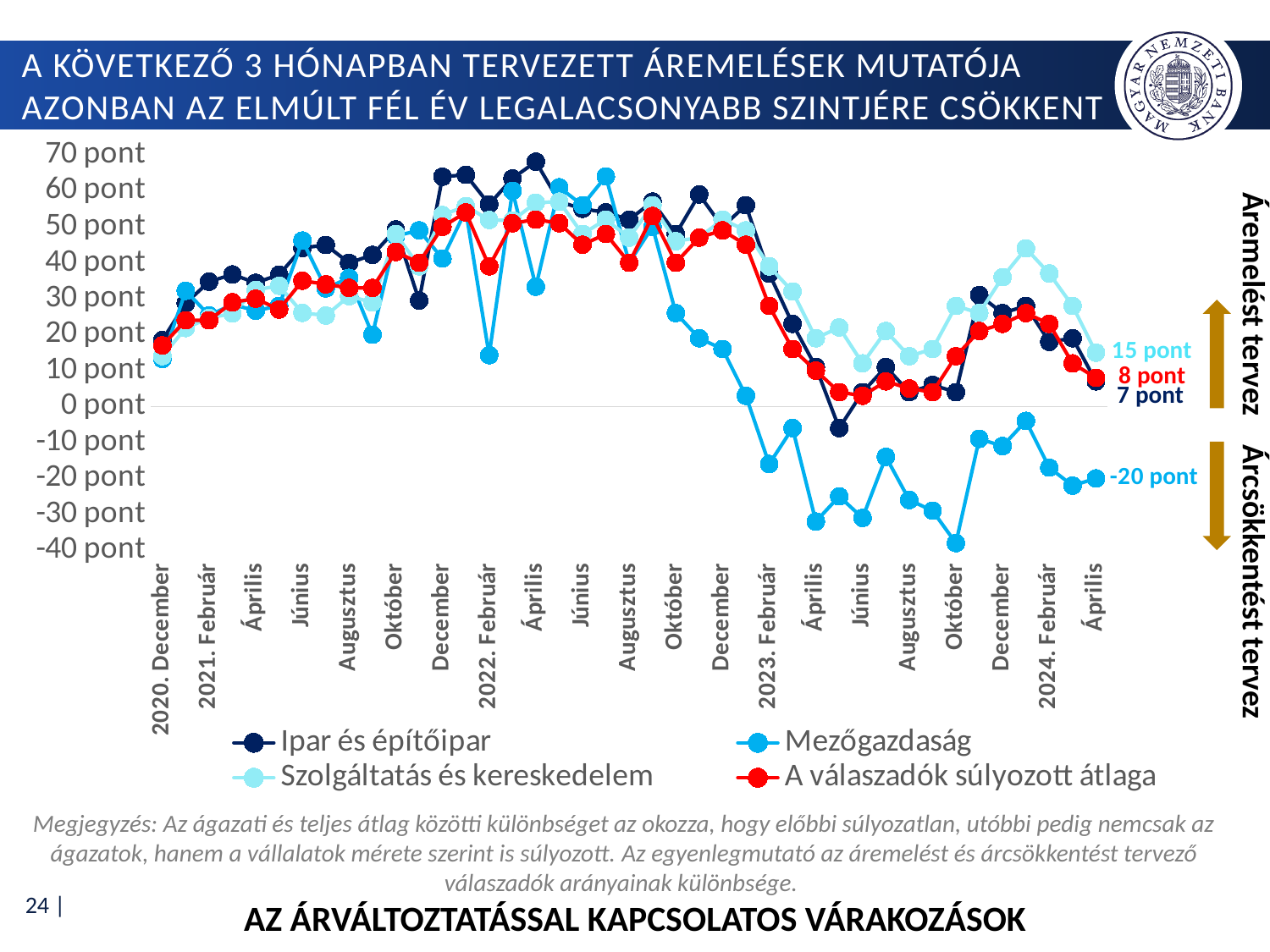
Which series has the lowest value at the last point (2024 Április)? Mezőgazdaság What is the value for Szolgáltatás és kereskedelem at the last point (2024 Április)? 15 pont Is the value for Ipar és építőipar in 2022 Április greater or less than 60 pont? greater What is the difference between the last values of Szolgáltatás és kereskedelem and Mezőgazdaság? 35 pont What is the value for Ipar és építőipar at the last point (2024 Április)? 7 pont What is the value for A válaszadók súlyozott átlaga at the last point (2024 Április)? 8 pont What is the value for Mezőgazdaság at the last point (2024 Április)? -20 pont Which series has the highest value at the last point (2024 Április)? Szolgáltatás és kereskedelem How many series does the legend list? 4 Does the Mezőgazdaság series rise or fall from 2022 December to 2023 Április? fall At the last point, which is larger: Ipar és építőipar or Mezőgazdaság? Ipar és építőipar What kind of chart is shown on the slide? line chart